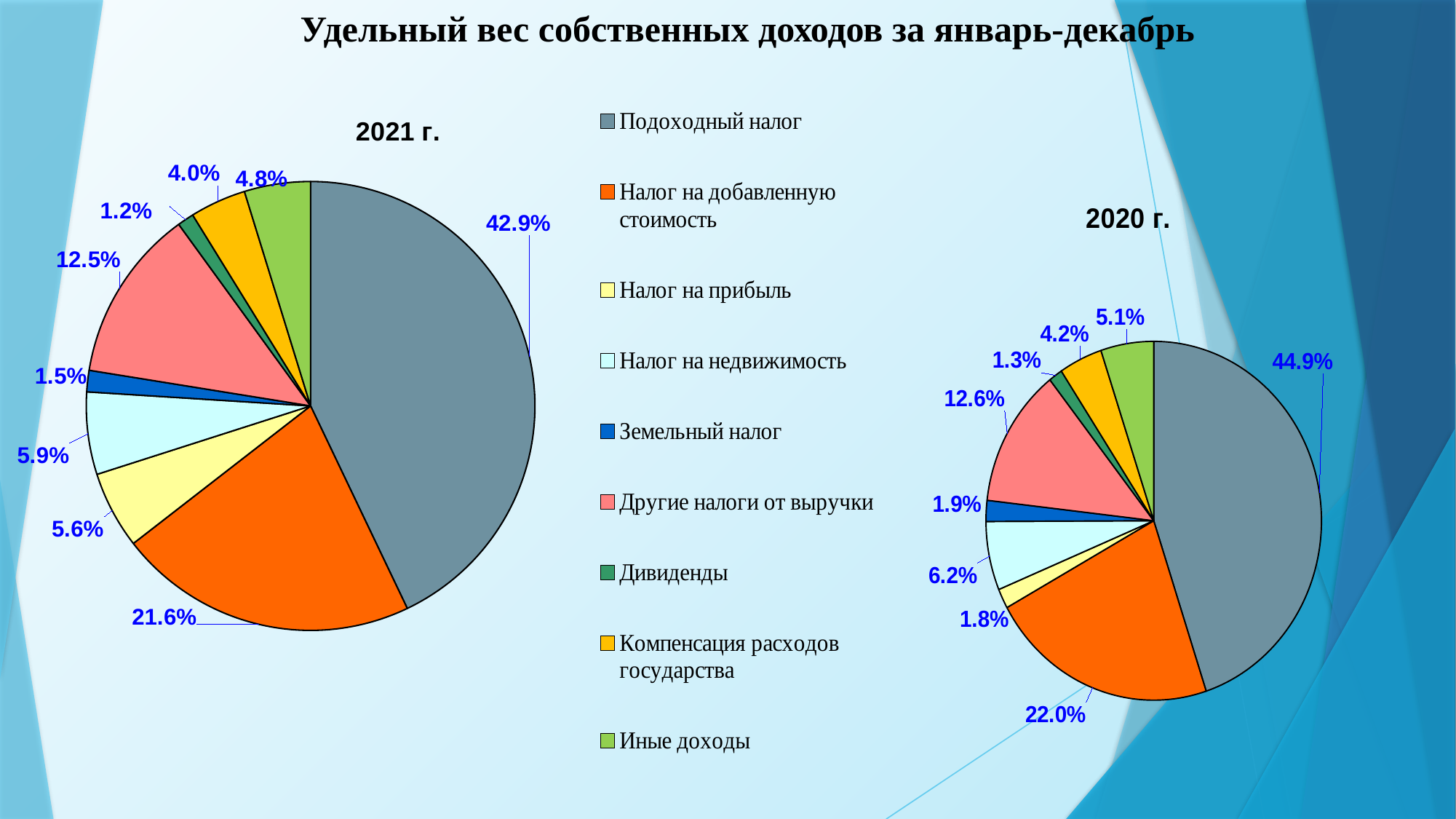
What is the difference between the Подоходный налог share in 2020 г. and in 2021 г.? 2.0% In the 2021 г. pie chart, which is larger: Налог на недвижимость or Налог на прибыль? Налог на недвижимость In the 2020 г. pie chart, what share does Налог на добавленную стоимость have? 22.0% In the 2021 г. pie chart, which category has the smallest share? Дивиденды What type of chart is used for 2021 г. and 2020 г.? Pie chart In the 2020 г. pie chart, which category has the largest share? Подоходный налог How many categories does the legend list? 9 What is the title of the slide? Удельный вес собственных доходов за январь-декабрь In the 2021 г. pie chart, what is the value for Другие налоги от выручки? 12.5% In the 2020 г. pie chart, what is the value for Иные доходы? 5.1% In the 2020 г. pie chart, what is the value for Налог на прибыль? 1.8% In the 2021 г. pie chart, what share does Подоходный налог have? 42.9%